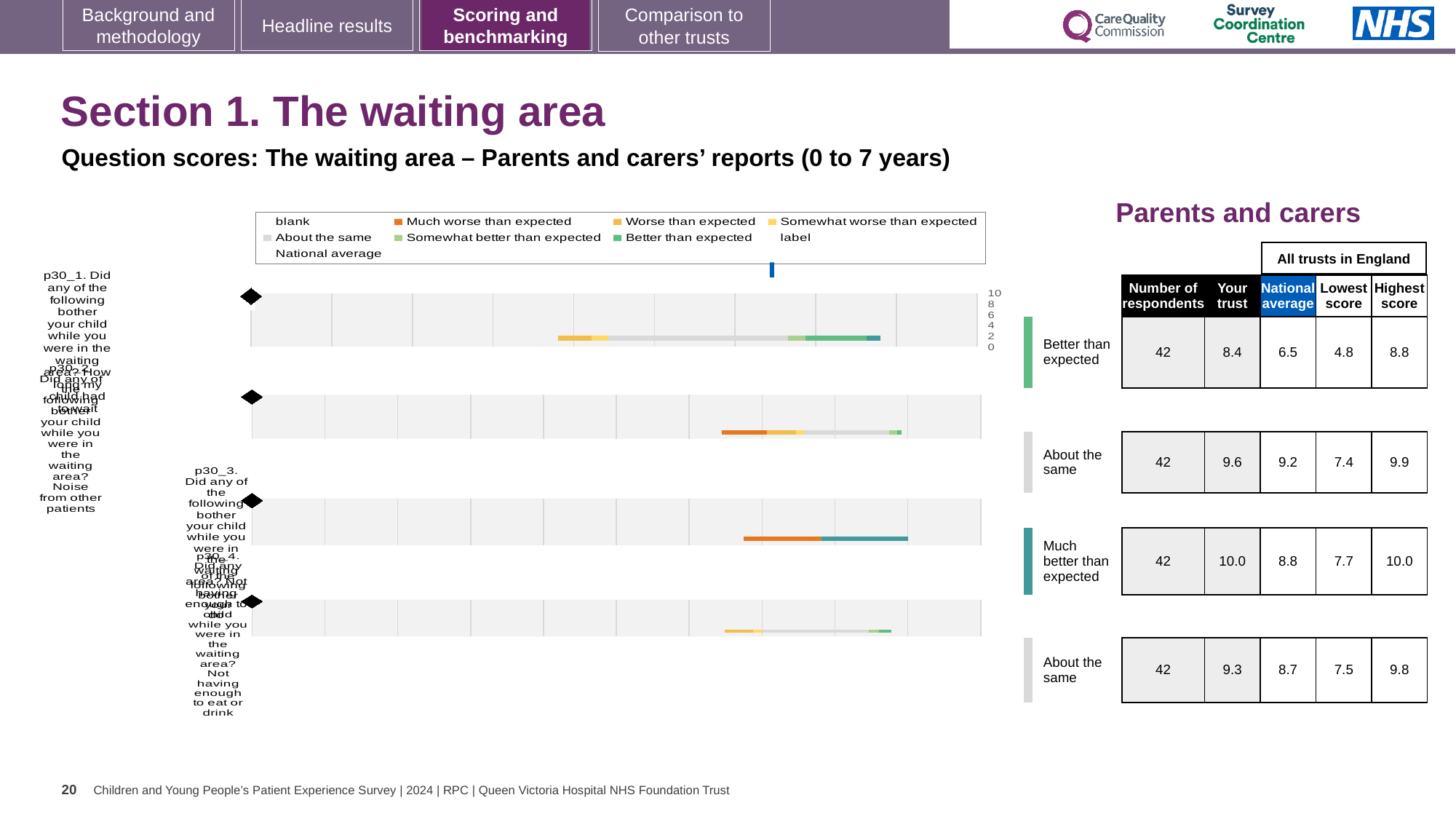
Is the 'Your trust' score for the second question row (p30_2) higher or lower than its national average? higher What is the national average for the first question row (p30_1)? 6.5 What is the difference between the 'Your trust' score and the national average for the first question row (p30_1)? 1.9 How many question rows (bars) are plotted in the waiting area chart? 4 How many entries does the legend of the waiting area chart list? 9 What is the 'Your trust' score for the first question row (p30_1, how long my child had to wait)? 8.4 What is the highest score across all trusts in England for the fourth question row (p30_4, not having enough to eat or drink)? 9.8 Which question row has the lowest national average? p30_1 (how long my child had to wait), 6.5 In the legend, what colour represents 'Much worse than expected'? orange What kind of chart is used to show the question scores for the waiting area? bar chart How many respondents are recorded for each question row? 42 Which question row has the highest 'Your trust' score? p30_3 (Not having enough to do), 10.0